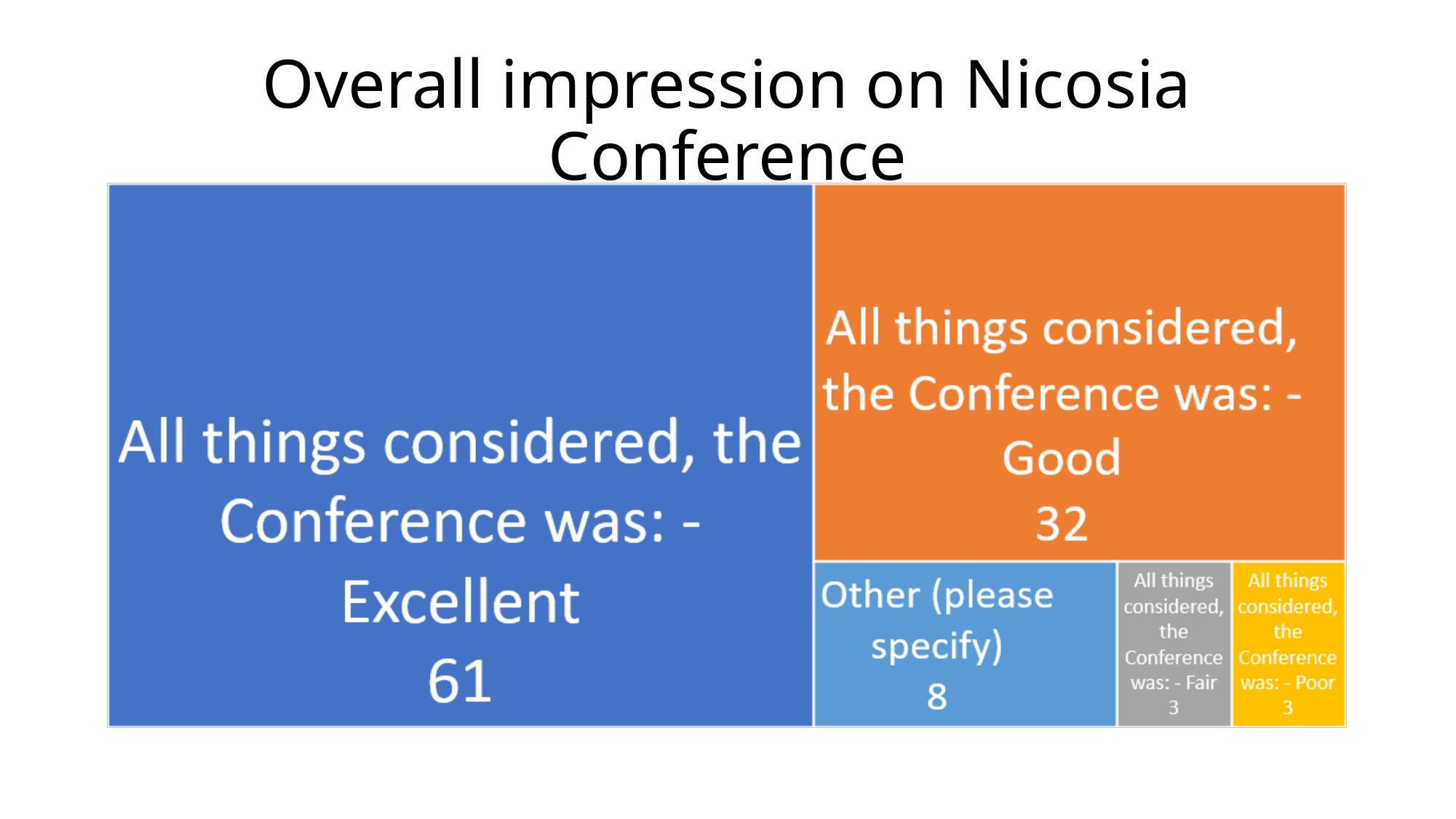
How many categories are shown in the chart? 5 What is the difference between the values for Good and Other (please specify)? 24 Which is larger, the value for Good or the value for Other (please specify)? Good What kind of chart is shown on the slide? Treemap What is the difference between the values for Excellent and Good? 29 What value is shown for "All things considered, the Conference was: - Excellent"? 61 Which category has the highest value? All things considered, the Conference was: - Excellent What value is shown for "Other (please specify)"? 8 What is the title of the slide? Overall impression on Nicosia Conference What value is shown for "All things considered, the Conference was: - Fair"? 3 What is the total of all the values shown in the chart? 107 What value is shown for "All things considered, the Conference was: - Good"? 32